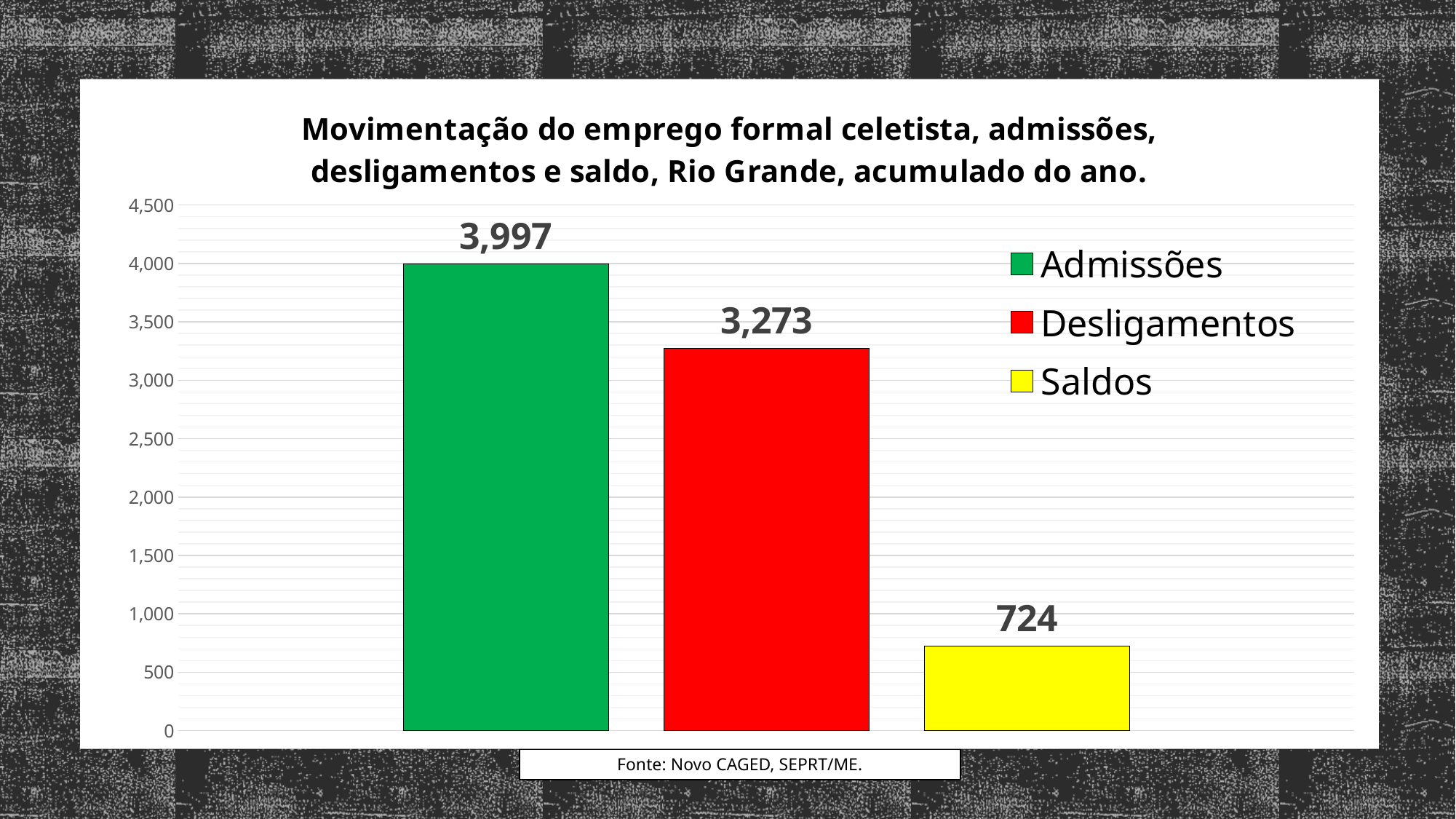
Which series has the lowest value? Saldos What is the difference between Desligamentos and Saldos? 2,549 What kind of chart is shown? bar chart What is the value for Desligamentos? 3,273 Is the value for Saldos greater or less than 1,000? less How many series does the legend list? 3 What is the difference between Admissões and Desligamentos? 724 Which is larger, Admissões or Desligamentos? Admissões Which series has the highest value? Admissões What colour is the bar for Desligamentos? red What is the value for Saldos? 724 What is the value for Admissões? 3,997